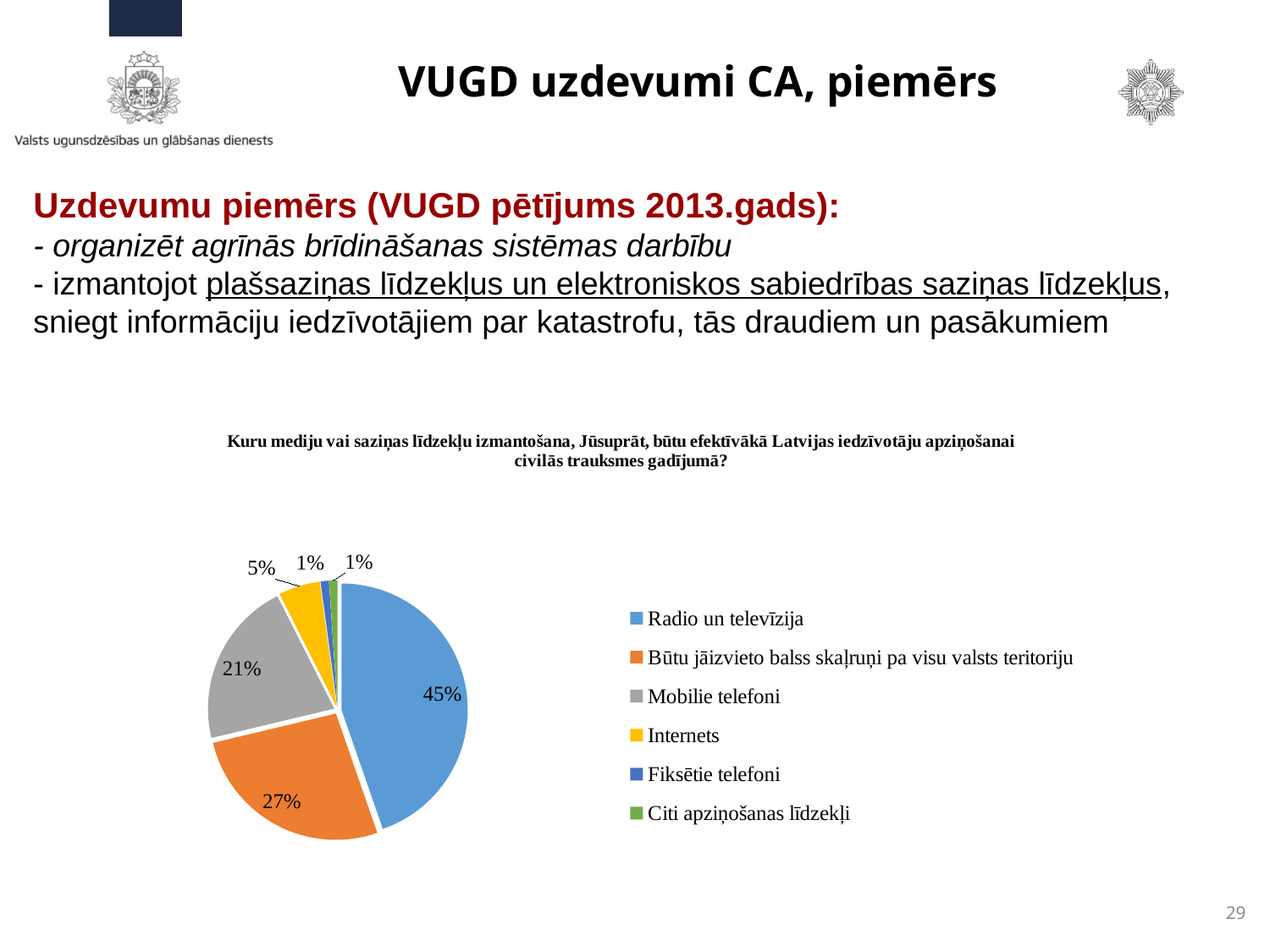
What kind of chart is shown on the slide? Pie chart What is the difference between the shares of "Būtu jāizvieto balss skaļruņi pa visu valsts teritoriju" and "Internets"? 22% What share of the pie does "Radio un televīzija" have? 45% Which is larger, the share for "Mobilie telefoni" or the share for "Būtu jāizvieto balss skaļruņi pa visu valsts teritoriju"? Būtu jāizvieto balss skaļruņi pa visu valsts teritoriju What colour is the slice for "Internets"? Yellow What share of the pie does "Internets" have? 5% What is the value for "Būtu jāizvieto balss skaļruņi pa visu valsts teritoriju"? 27% What share of the pie does "Mobilie telefoni" have? 21% Which category has the largest slice of the pie? Radio un televīzija What is the difference between the shares of "Radio un televīzija" and "Mobilie telefoni"? 24% What is the value for "Fiksētie telefoni"? 1% How many categories does the pie chart have? 6